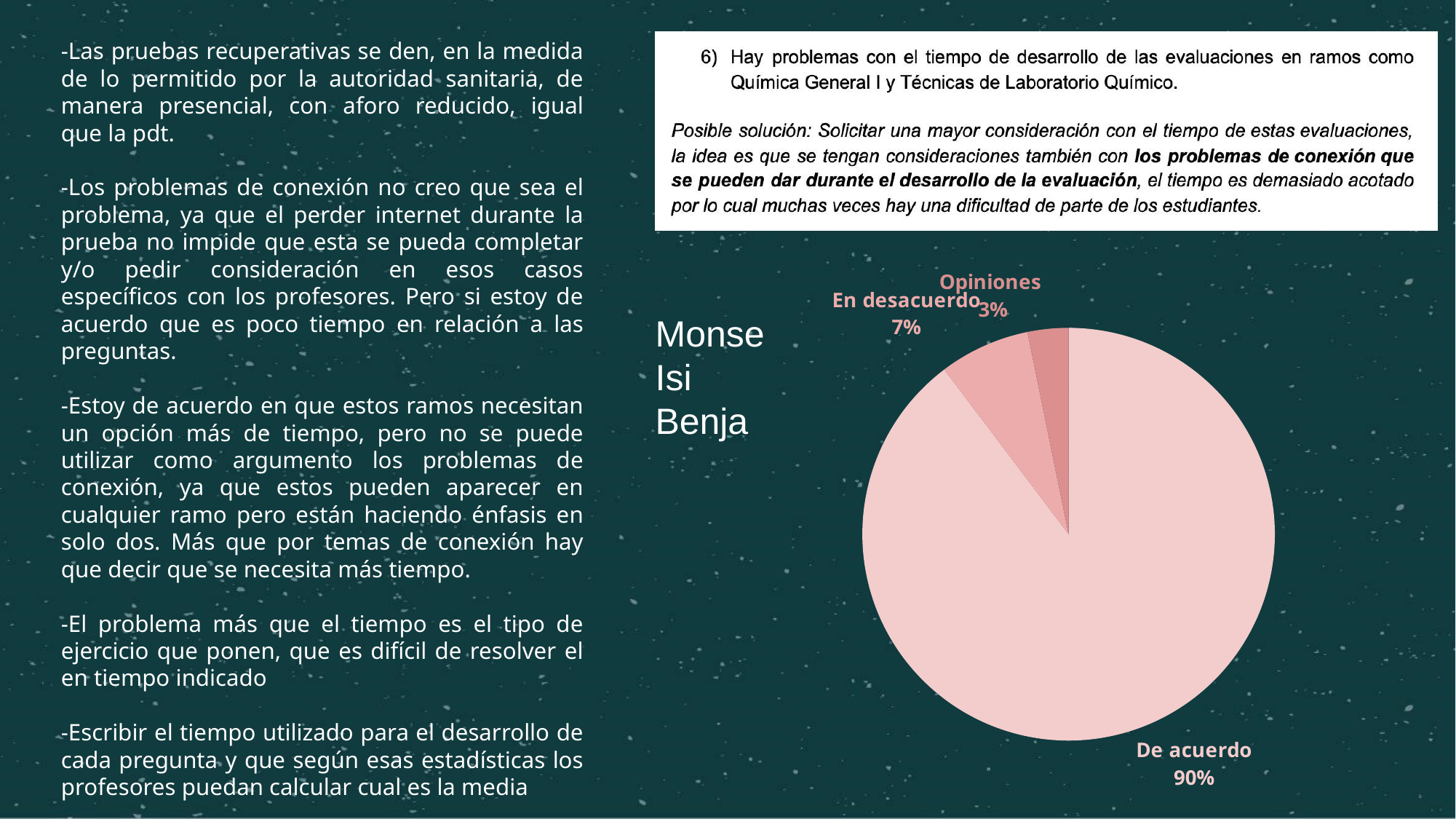
Which is larger, the share for "En desacuerdo" or the share for "Opiniones"? En desacuerdo What is the difference in percentage points between "De acuerdo" and "En desacuerdo"? 83 What is the combined share of "En desacuerdo" and "Opiniones"? 10% What share of the pie does "De acuerdo" represent? 90% What is the difference in percentage points between "En desacuerdo" and "Opiniones"? 4 Which slice of the pie chart is the largest? De acuerdo What kind of chart is shown on the slide? pie chart What share of the pie does "Opiniones" represent? 3% What share of the pie does "En desacuerdo" represent? 7% Which slice of the pie chart is the smallest? Opiniones How many slices does the pie chart have? 3 Which slice of the pie chart is drawn in the darkest shade of pink? Opiniones